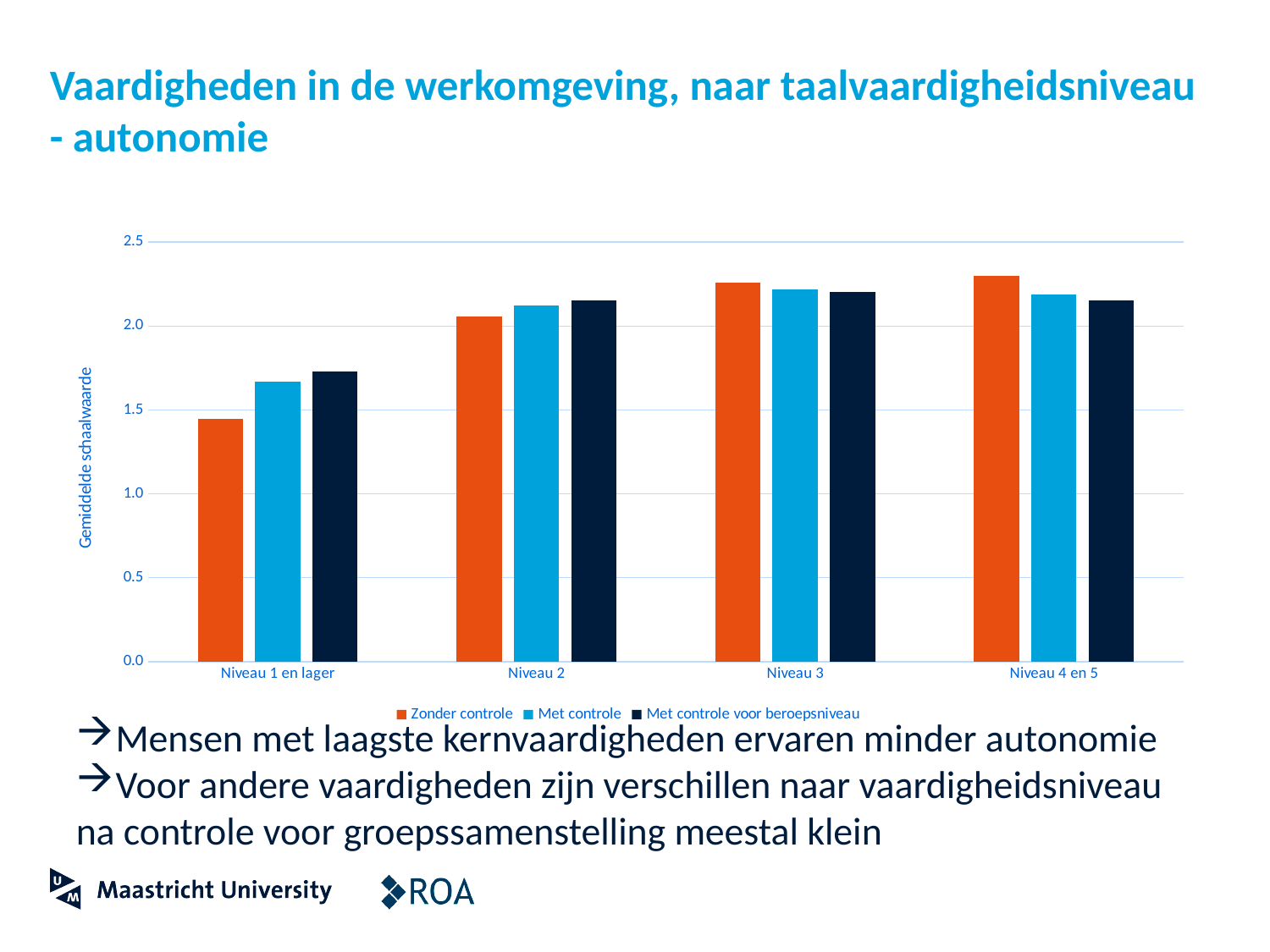
What kind of chart is shown on the slide? bar chart Is the value for Met controle voor beroepsniveau at Niveau 3 greater or less than 2.5? less At Niveau 1 en lager, which is larger: Zonder controle or Met controle? Met controle How many series does the legend list? 3 Is the value for Met controle at Niveau 1 en lager greater or less than 1.5? greater Do the values for Zonder controle rise or fall from Niveau 1 en lager to Niveau 4 en 5? rise What is the label of the y axis? Gemiddelde schaalwaarde How many categories (taalvaardigheidsniveaus) are shown on the x axis? 4 Which category has the lowest value for Zonder controle? Niveau 1 en lager Is the value for Zonder controle at Niveau 2 greater or less than 2.0? greater At Niveau 1 en lager, which of the three series has the highest value? Met controle voor beroepsniveau